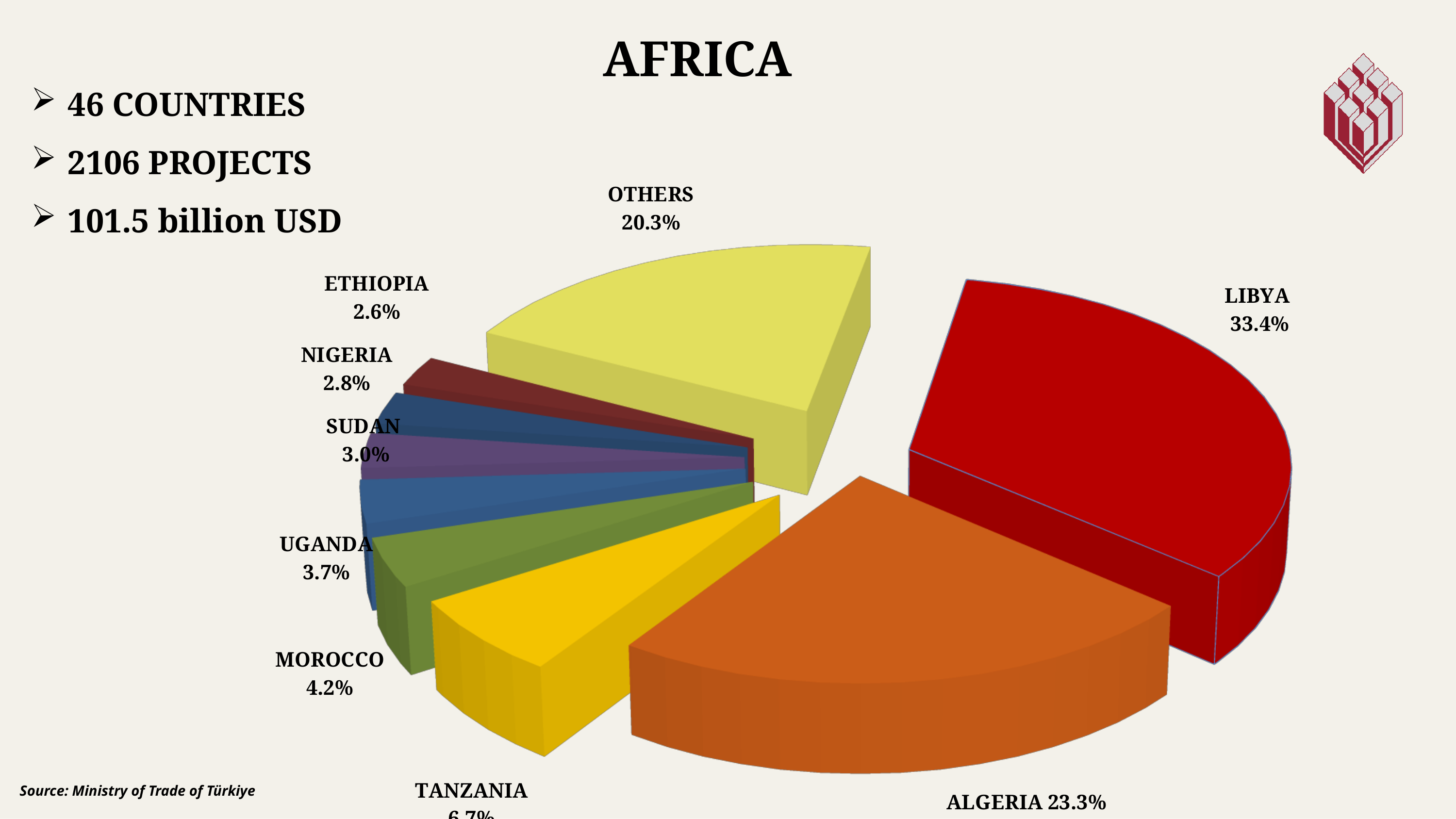
What percentage is shown for Morocco? 4.2% What is the value shown for Sudan? 3.0% What is the value of the Others slice? 20.3% What share of the pie does Libya account for? 33.4% Which has a larger share, Uganda or Sudan? Uganda Which country has the largest slice of the pie? Libya What colour is the Libya slice? Red How many slices does the pie chart have? 9 Which labelled slice has the smallest percentage? Ethiopia What type of chart is shown on the slide? Pie chart How many percentage points larger is Libya's share than Algeria's? 10.1 percentage points What percentage is shown for Algeria? 23.3%